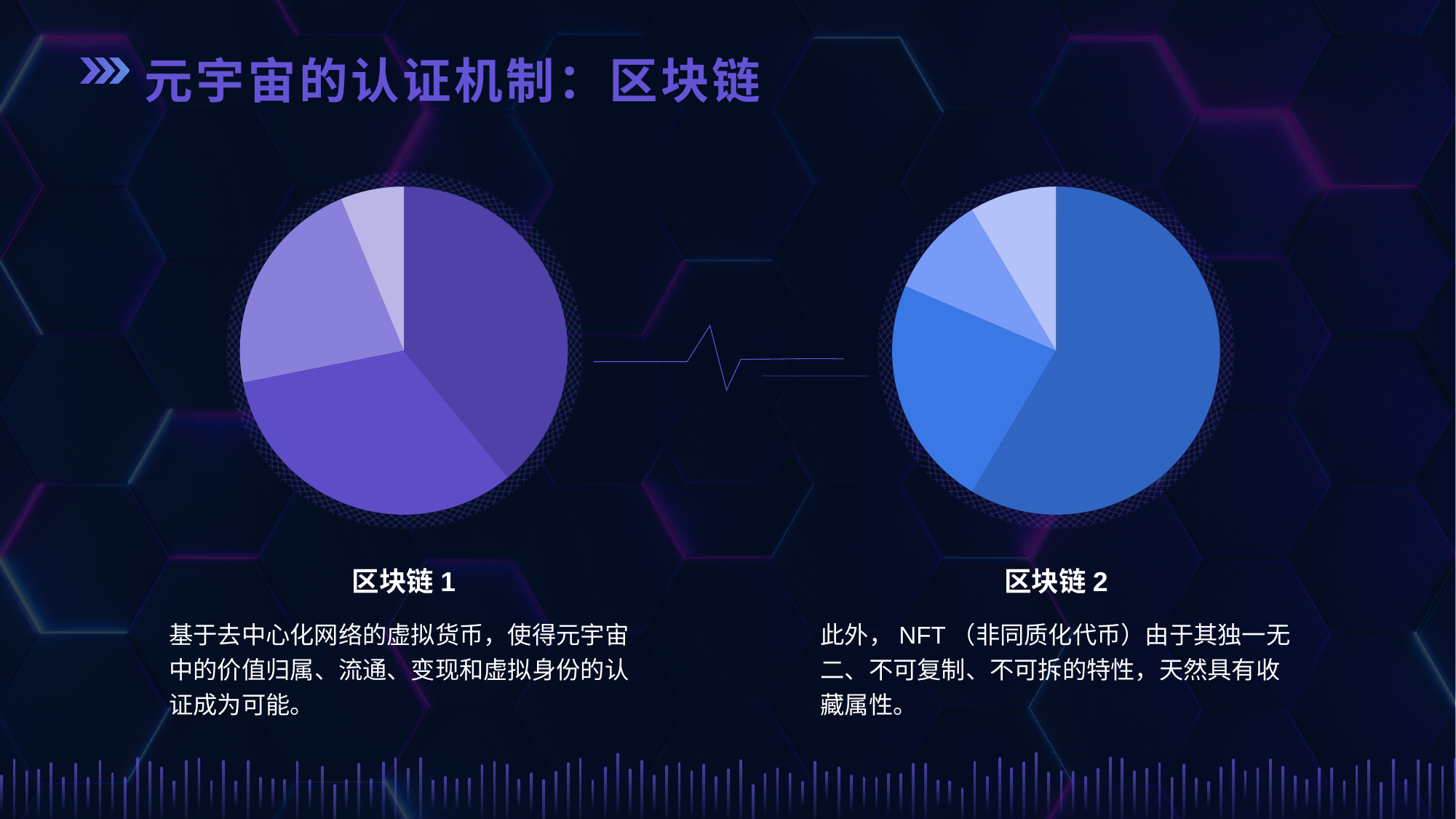
What is the caption under the right pie chart? 区块链 2 How many slices does the left pie chart (区块链 1) have? 4 In the right pie chart (区块链 2), which is larger: the dark blue slice or the lightest blue slice? the dark blue slice What kind of chart is shown on the right side of the slide, labelled 区块链 2? pie chart In the left pie chart (区块链 1), which is larger: the dark purple slice or the lightest purple slice? the dark purple slice In the right pie chart (区块链 2), which slice is the smallest? the lightest blue slice In the left pie chart (区块链 1), which slice is the smallest? the lightest purple slice How many slices does the right pie chart (区块链 2) have? 4 How many pie charts are on the slide? 2 In the left pie chart (区块链 1), which slice is the largest? the dark purple slice In the right pie chart (区块链 2), which slice is the largest? the dark blue slice What kind of chart is shown on the left side of the slide, labelled 区块链 1? pie chart